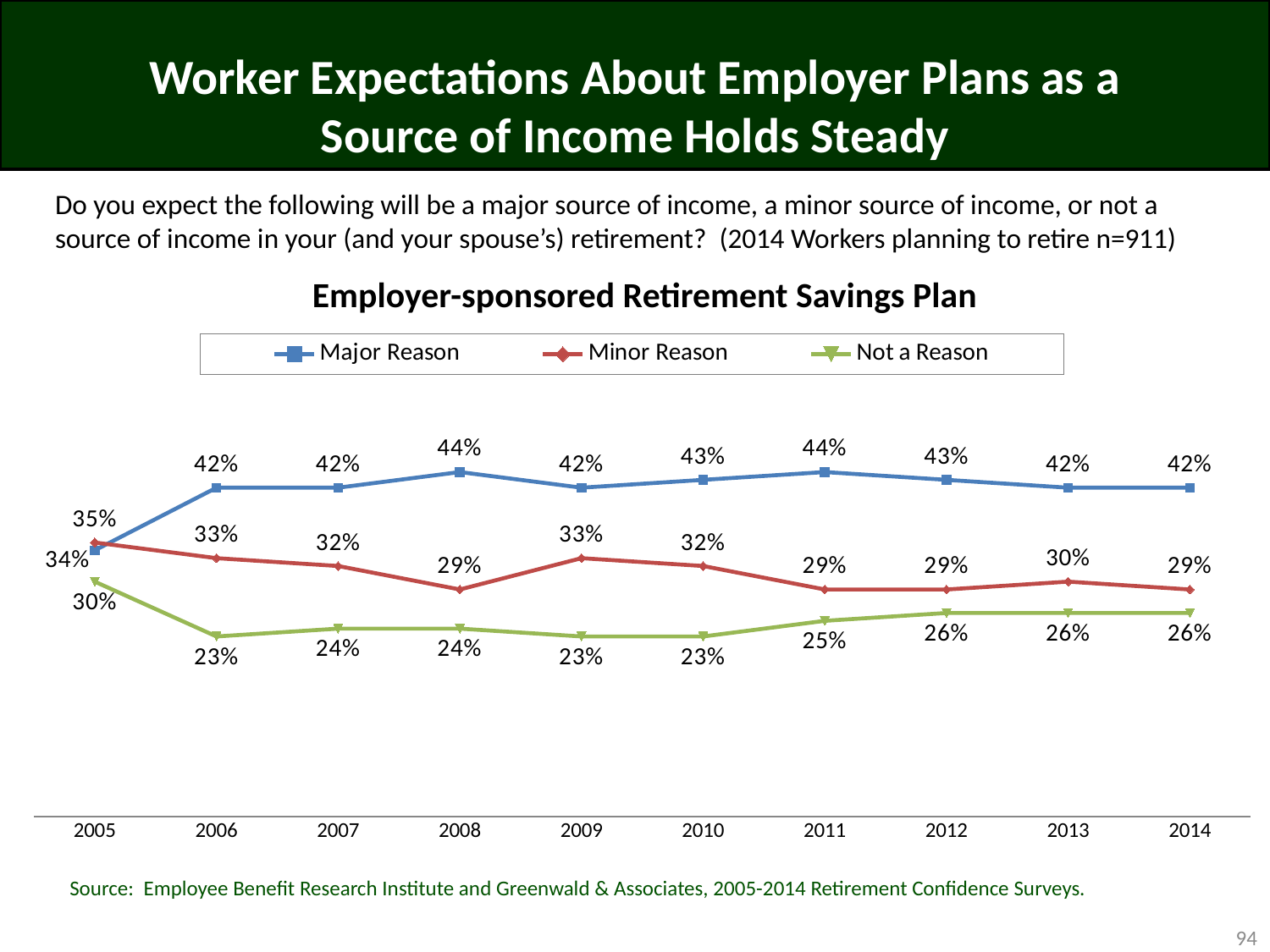
How many series does the legend list? 3 In which years does the Major Reason series reach its highest value? 2008 and 2011 What kind of chart is shown on the slide? Line chart In 2005, which is larger: Major Reason or Minor Reason? Minor Reason What is the difference between Major Reason and Minor Reason in 2014? 13 percentage points Did the Not a Reason series rise or fall from 2005 to 2006? Fall What is the lowest value shown for the Not a Reason series? 23% What is the value for Not a Reason in 2005? 30% What is the value for Major Reason in 2014? 42% How many years are shown on the x axis? 10 What is the value for Minor Reason in 2009? 33% What is the title of the chart? Employer-sponsored Retirement Savings Plan